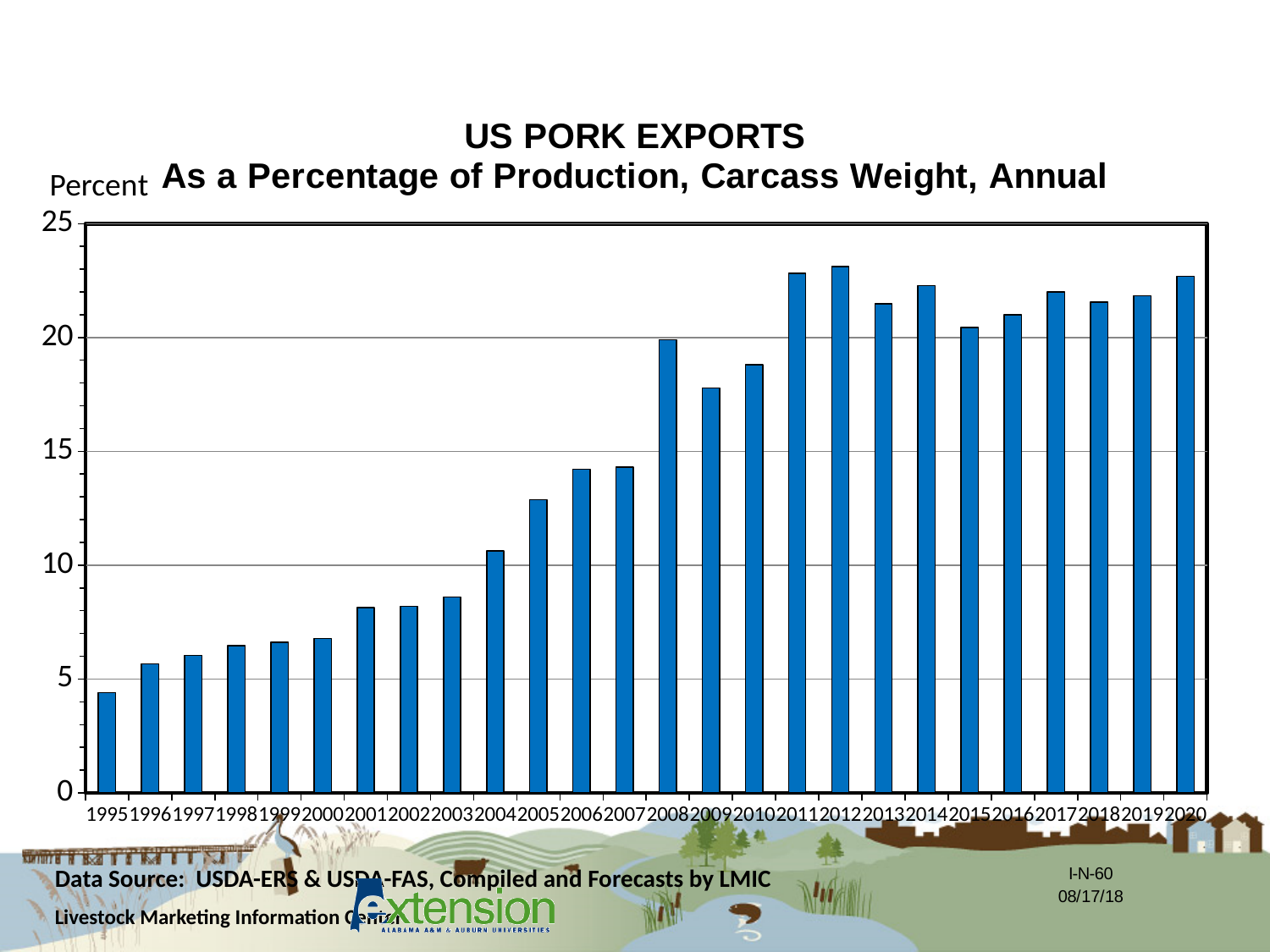
Do the values generally rise or fall from 1995 to 2020? rise Is the value for 2006 greater or less than 15? less Is the value for 2009 greater or less than 20? less Is the value for 1995 greater or less than 5? less What is the label on the vertical axis of the chart? Percent Which year has the larger value, 2008 or 2009? 2008 Which year has the larger value, 2004 or 2005? 2005 Which year has the lowest value for US pork exports as a percentage of production? 1995 How many years are plotted on the x axis? 26 What kind of chart is shown on the slide? bar chart